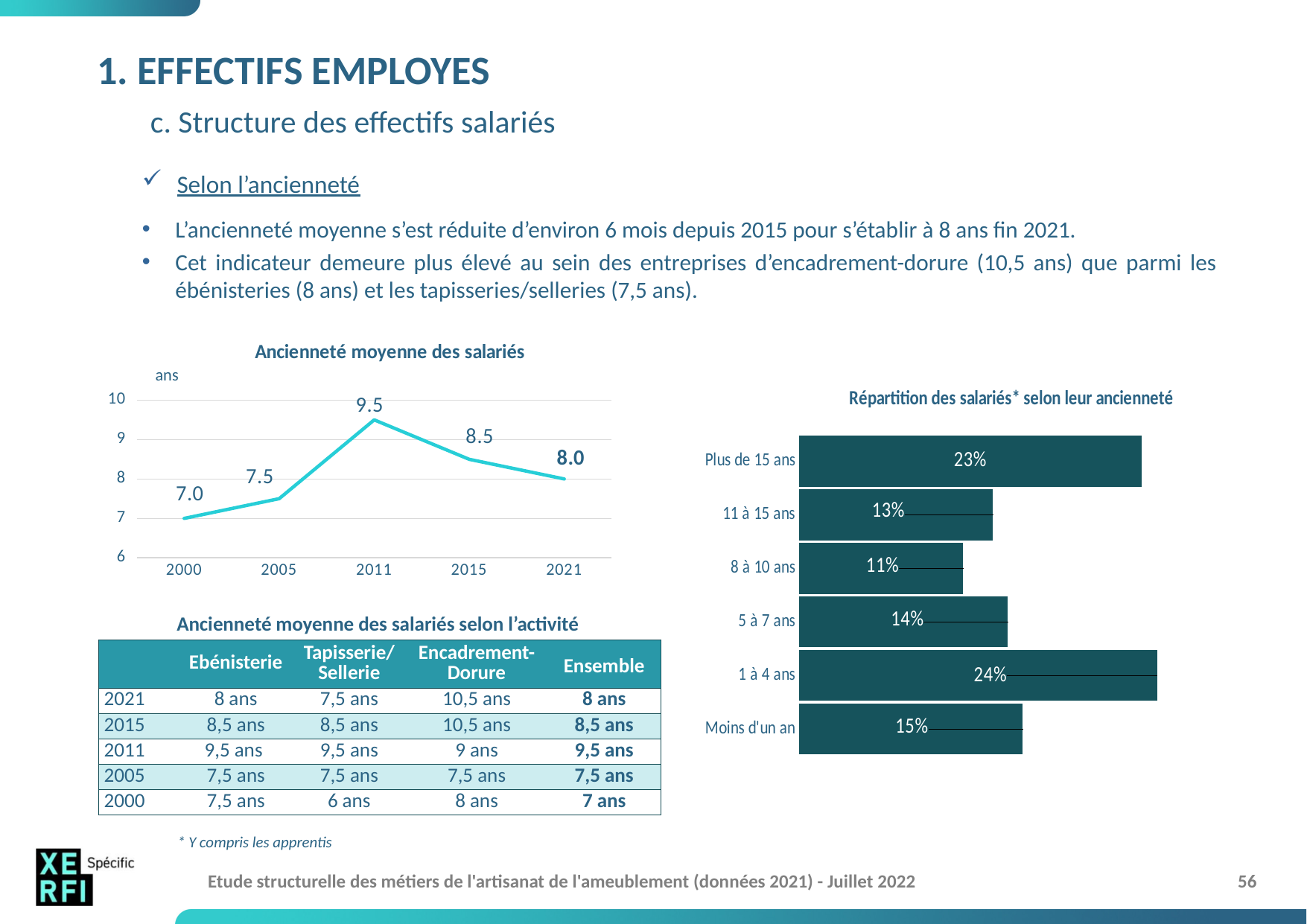
In the chart 'Ancienneté moyenne des salariés', how many years are plotted on the x axis? 5 In the chart 'Répartition des salariés* selon leur ancienneté', which category has the highest value? 1 à 4 ans In the chart 'Répartition des salariés* selon leur ancienneté', which is larger: 'Plus de 15 ans' or 'Moins d'un an'? Plus de 15 ans In the chart 'Ancienneté moyenne des salariés', do the values rise or fall between 2011 and 2021? fall In the chart 'Ancienneté moyenne des salariés', which year has the highest value? 2011 In the chart 'Ancienneté moyenne des salariés', what is the value for 2021? 8.0 What kind of chart is 'Répartition des salariés* selon leur ancienneté'? bar chart In the chart 'Ancienneté moyenne des salariés', what is the value for 2011? 9.5 In the chart 'Ancienneté moyenne des salariés', which year has the lowest value? 2000 In the chart 'Ancienneté moyenne des salariés', what is the difference between the values for 2011 and 2021? 1.5 What kind of chart is 'Ancienneté moyenne des salariés'? line chart In the chart 'Répartition des salariés* selon leur ancienneté', what is the value for '8 à 10 ans'? 11%